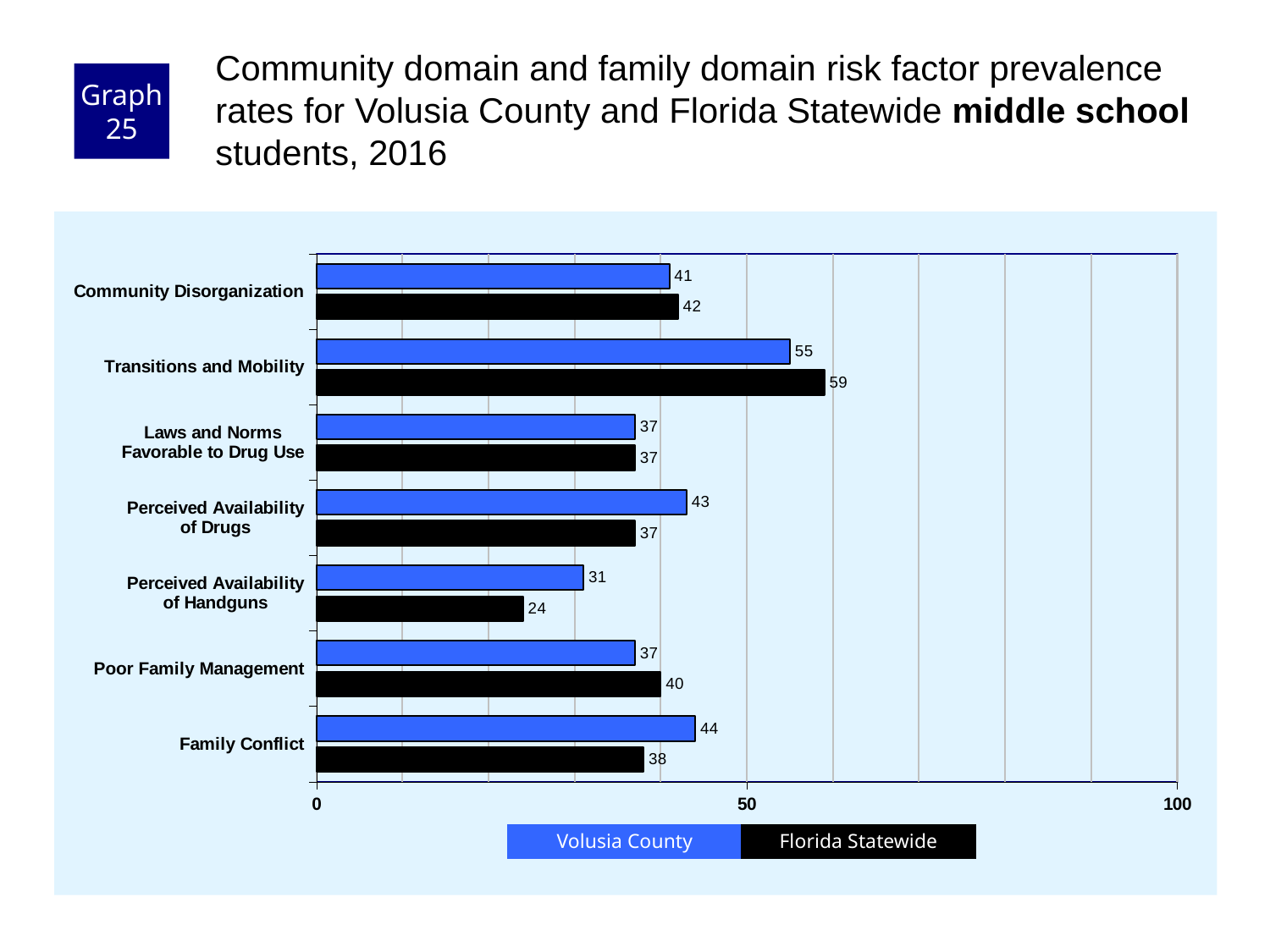
What is the difference between the Florida Statewide and Volusia County values for Transitions and Mobility? 4 Which colour represents Florida Statewide in the chart? black Is the Florida Statewide value for Transitions and Mobility greater or less than 50? greater What is the Florida Statewide value for Perceived Availability of Handguns? 24 What kind of chart is shown on the slide? bar chart What is the Volusia County value for Family Conflict? 44 How many risk factor categories are shown on the chart? 7 Which risk factor has the highest Florida Statewide value? Transitions and Mobility Which risk factor has the lowest Volusia County value? Perceived Availability of Handguns How many series does the legend list? 2 For Perceived Availability of Drugs, which is larger: the Volusia County value or the Florida Statewide value? Volusia County What is the Volusia County value for Transitions and Mobility? 55